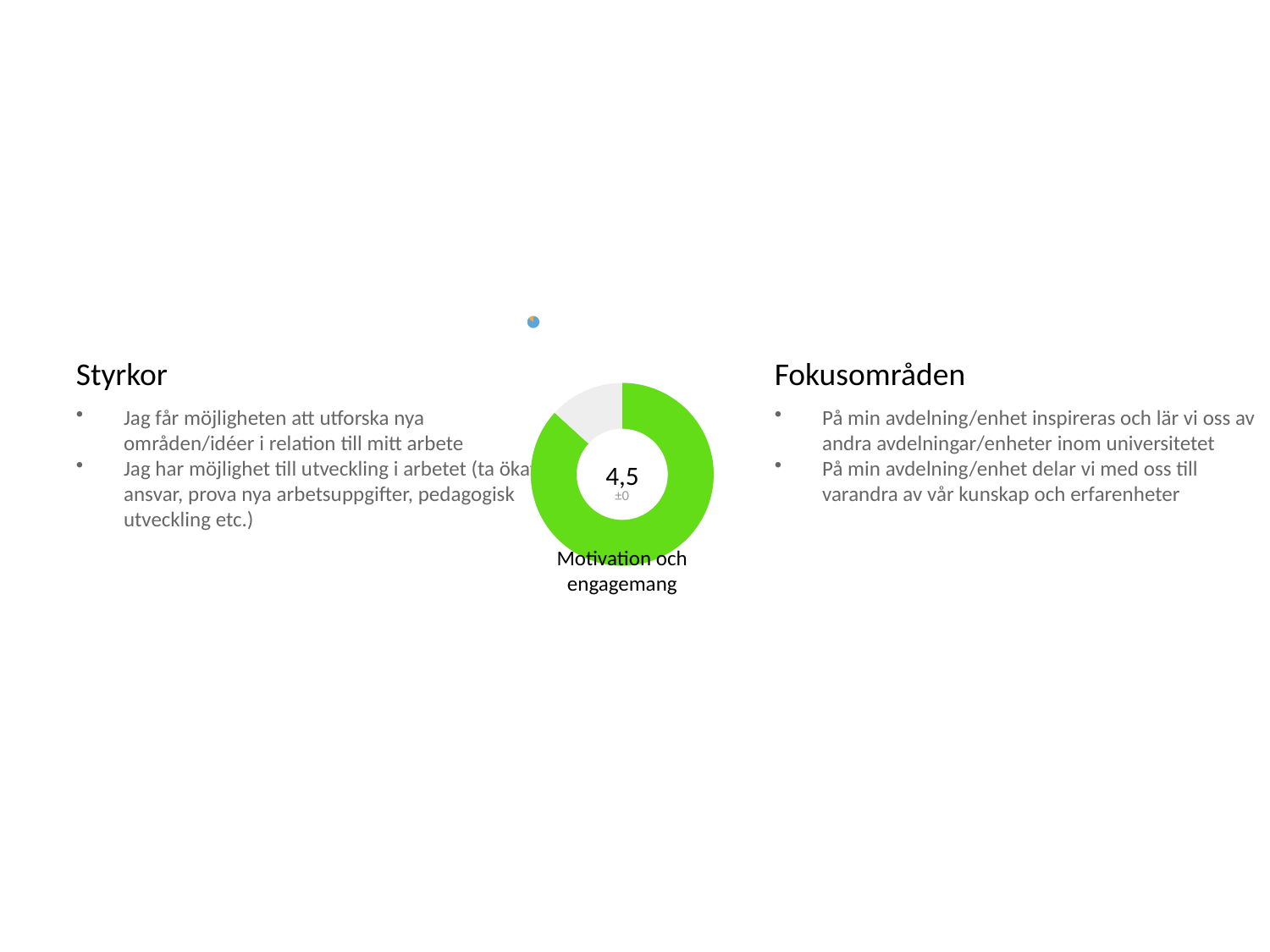
How many segments does the doughnut chart have? 2 What kind of chart is shown in the centre of the slide? Doughnut chart What is the label shown beneath the doughnut chart? Motivation och engagemang Is the value shown in the doughnut chart greater or less than 4? greater Which segment of the doughnut chart is larger, the green one or the grey one? The green one What change value is printed under the 4,5 in the centre of the doughnut chart? ±0 What value is printed in the centre of the doughnut chart? 4,5 What colour is the filled portion of the doughnut chart? Green